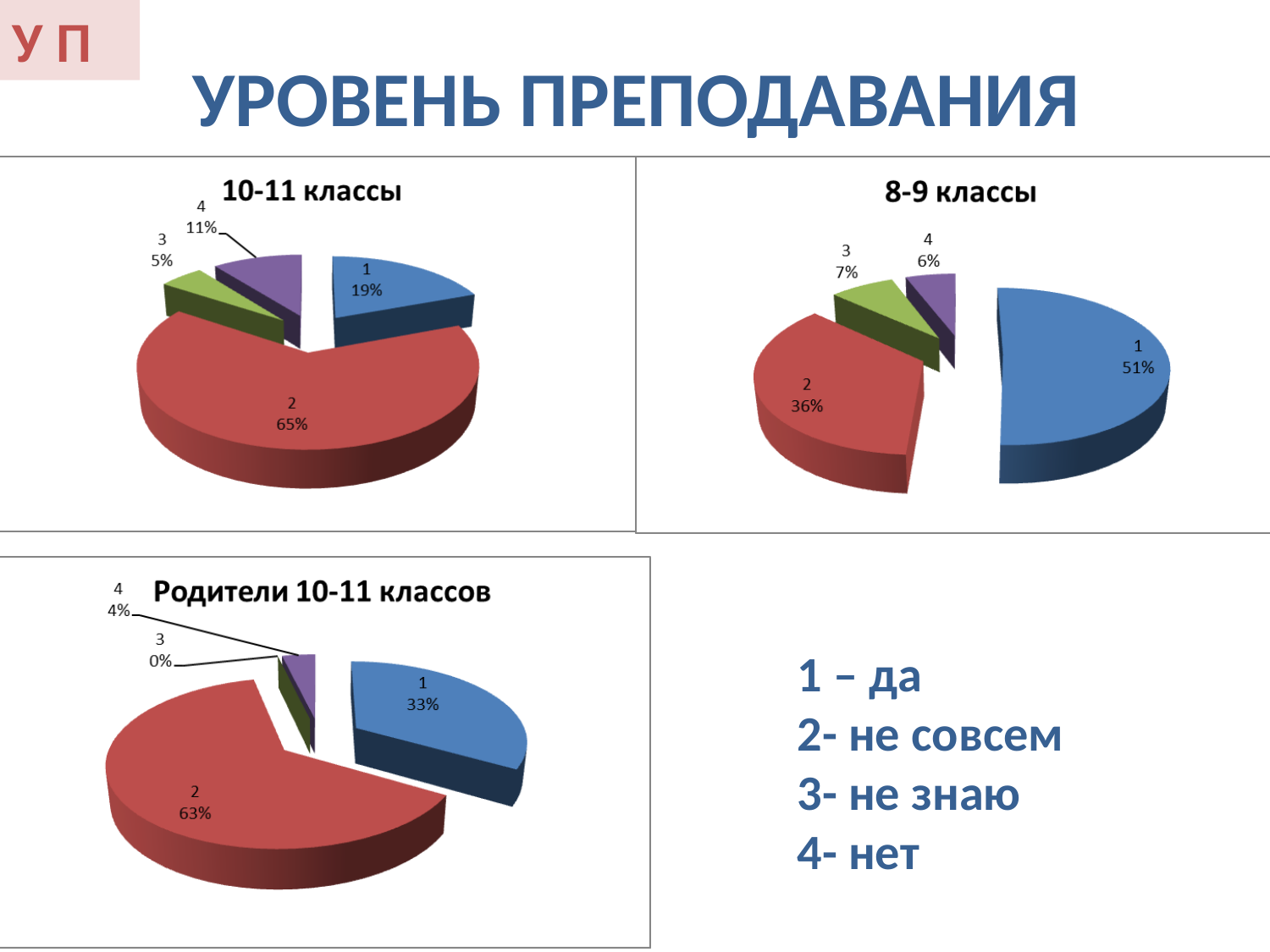
In the "8-9 классы" chart, which category has the smallest share? 4 In the "10-11 классы" chart, which category has the largest share? 2 In the "10-11 классы" chart, what percentage is shown for category 2? 65% In the "Родители 10-11 классов" chart, what percentage is shown for category 4? 4% In the "8-9 классы" chart, which is larger: the share of category 1 or category 2? 1 In the "10-11 классы" chart, what percentage is shown for category 3? 5% In the "8-9 классы" chart, what percentage is shown for category 1? 51% How many slices does the "Родители 10-11 классов" chart have? 4 In the "Родители 10-11 классов" chart, which category has the smallest share? 3 What type of chart is the "8-9 классы" chart? Pie chart What is the title of the chart in the bottom-left of the slide? Родители 10-11 классов In the "10-11 классы" chart, what is the difference between the shares of category 2 and category 1? 46%